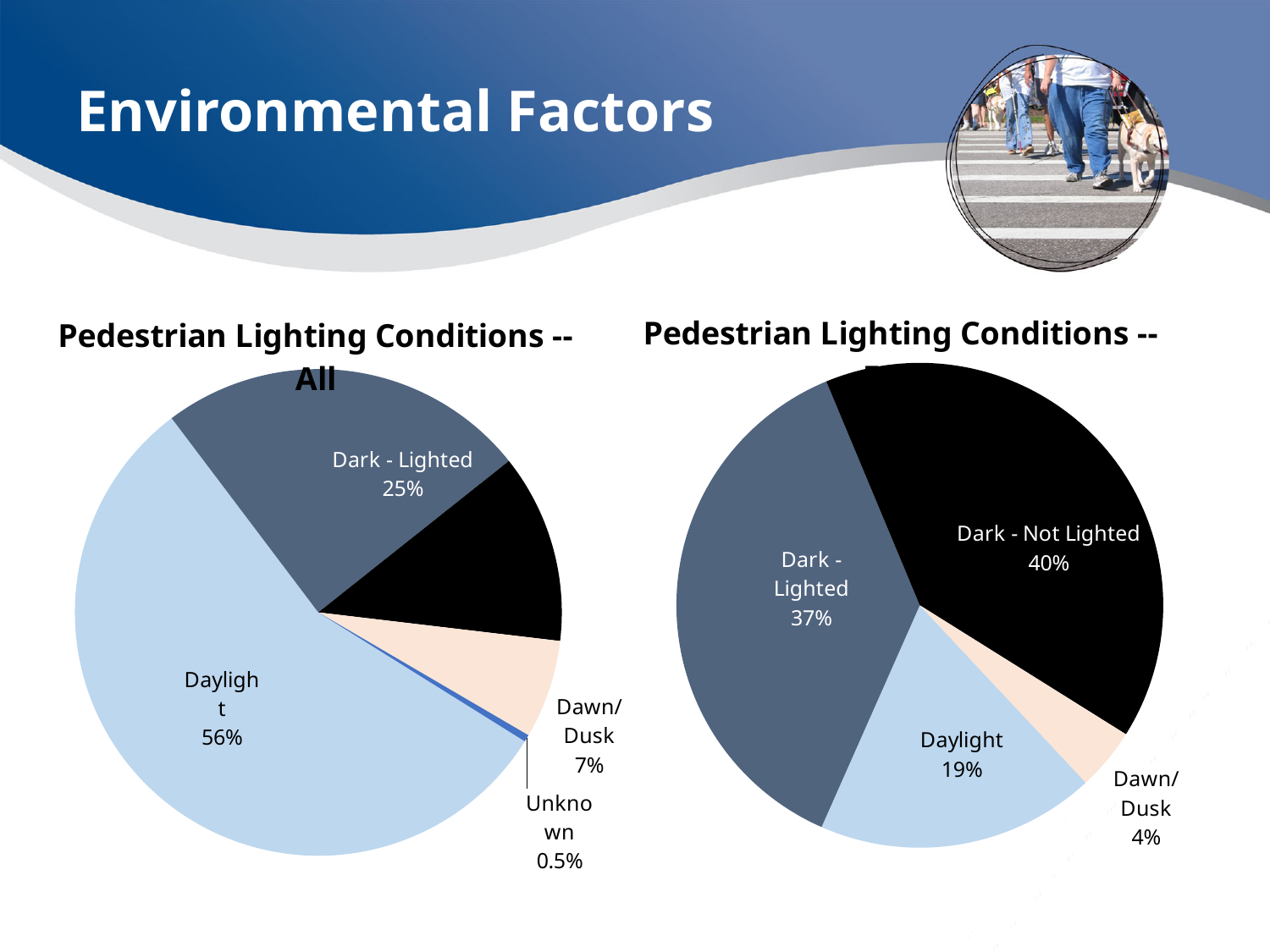
Which chart shows a larger share for Daylight, the left chart or the right chart? The left chart In the left chart (Pedestrian Lighting Conditions -- All), which category has the largest share? Daylight What type of chart is used on this slide? Pie chart In the right chart, what is the difference in percentage points between Dark - Not Lighted and Dark - Lighted? 3 percentage points How many slices does the right chart have? 4 In the left chart (Pedestrian Lighting Conditions -- All), what share is Dark - Lighted? 25% In the right chart, what share is Dark - Not Lighted? 40% In the left chart (Pedestrian Lighting Conditions -- All), what share is Daylight? 56% In the left chart (Pedestrian Lighting Conditions -- All), which labelled category has the smallest share? Unknown In the right chart, what share is Dawn/Dusk? 4% In the left chart (Pedestrian Lighting Conditions -- All), what share is Unknown? 0.5% In the right chart, which category has the largest share? Dark - Not Lighted